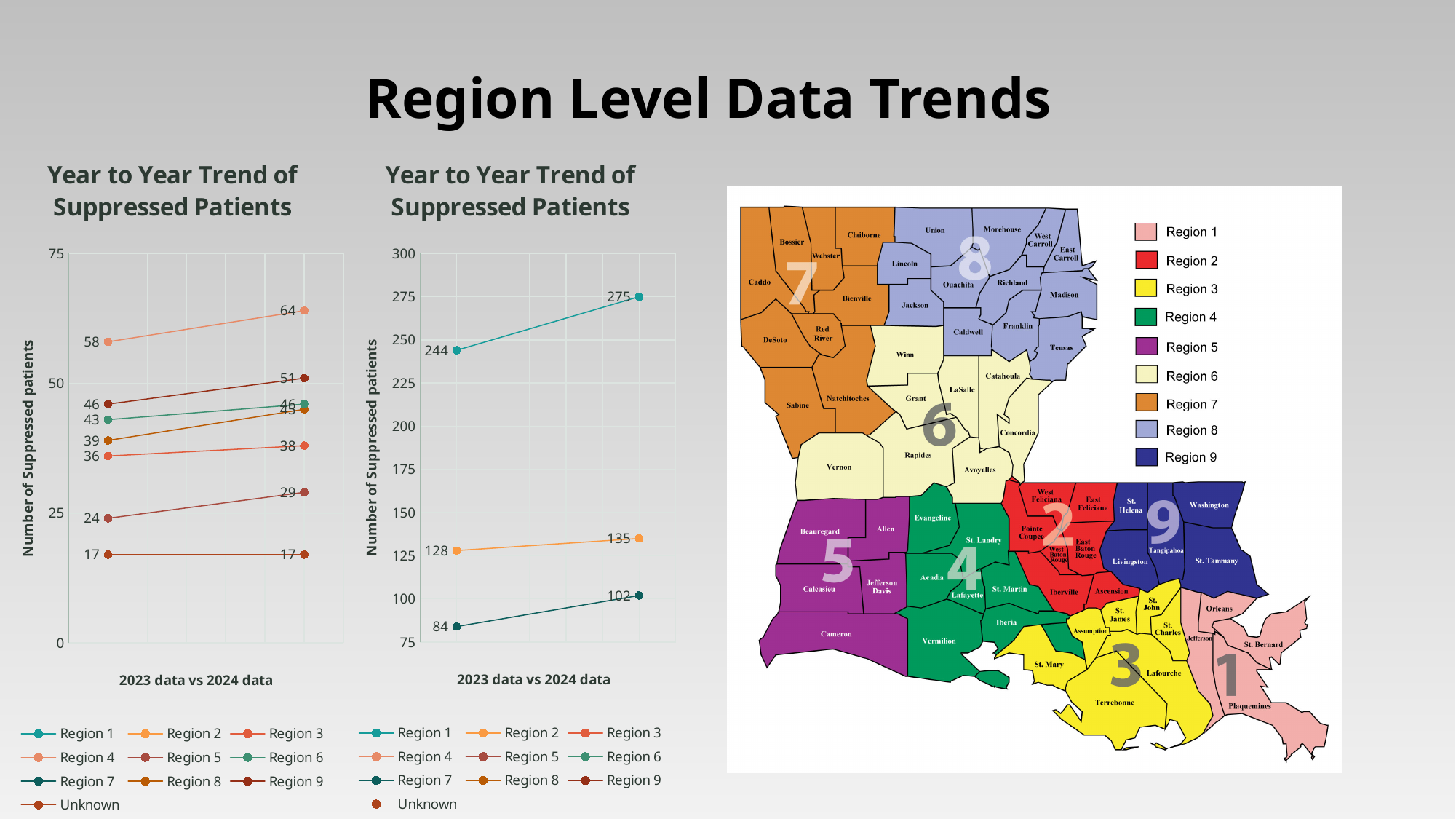
In the left line chart (y-axis up to 75), does the line that starts at 17 in 2023 rise, fall, or stay flat in 2024? Stays flat In the middle line chart (y-axis up to 300), what is the 2023 value for Region 2? 128 In the left line chart (y-axis up to 75), what is the highest 2024 value shown? 64 In the left line chart (y-axis up to 75), what is the lowest 2024 value shown? 17 In the middle line chart (the one with a y-axis up to 300), what is the 2024 value for Region 1? 275 What kind of chart is the left chart titled 'Year to Year Trend of Suppressed Patients'? Line chart In the middle line chart (y-axis up to 300), what is the 2024 value for Region 7? 102 In the middle line chart (y-axis up to 300), by how much did Region 1 increase from 2023 to 2024? 31 How many series does the legend of the left line chart list? 10 In the middle line chart (y-axis up to 300), by how much did Region 7 increase from 2023 to 2024? 18 In the middle line chart (y-axis up to 300), what is the 2023 value for Region 1? 244 In the left line chart (y-axis up to 75), what is the 2023 value for Region 4? 58